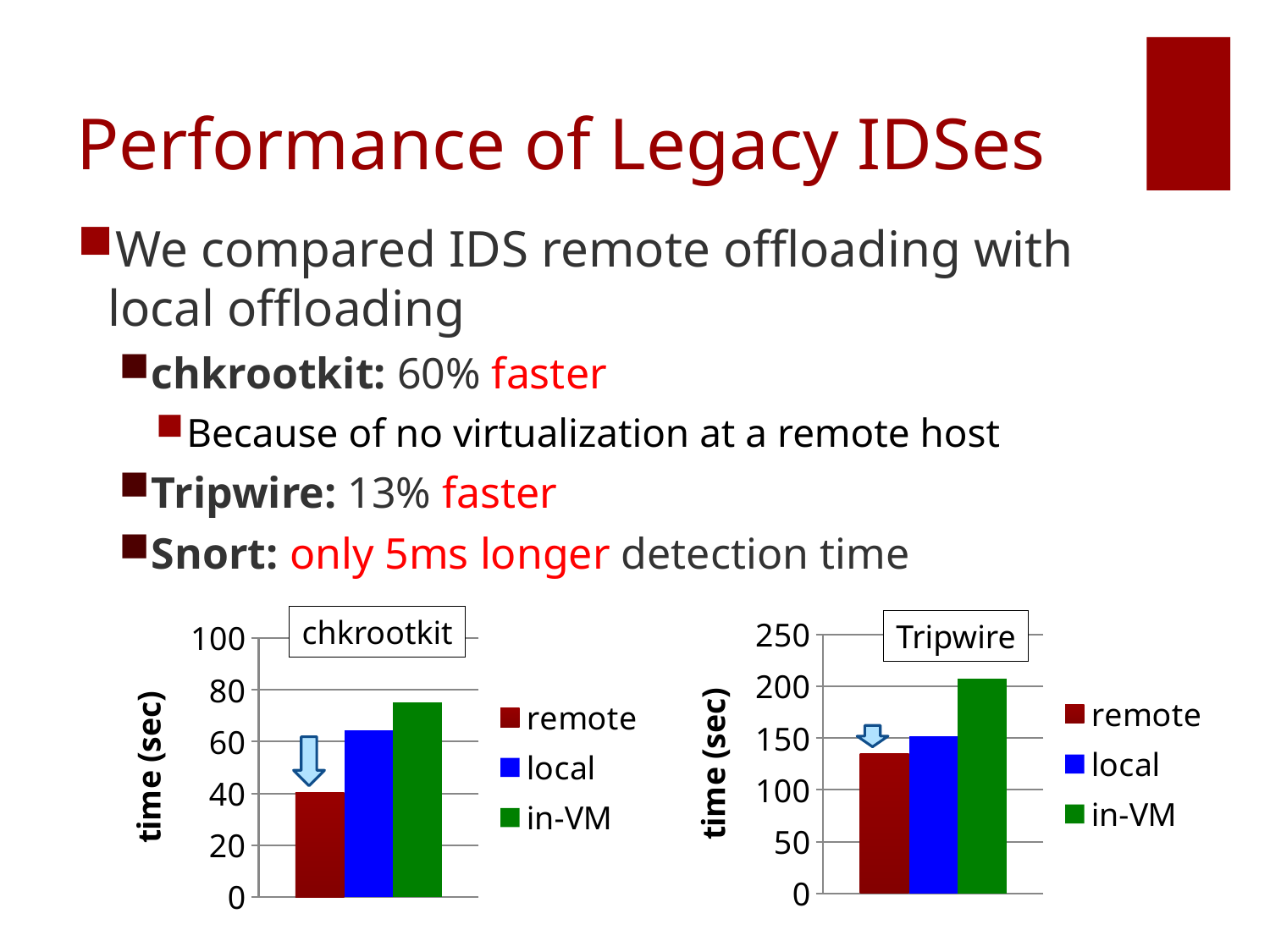
In the Tripwire chart, which series has the lowest time? remote In the Tripwire chart, is the value for remote greater or less than 150? less In the chkrootkit chart, is the value for local greater or less than 60? greater In the Tripwire chart, is the value for in-VM greater or less than 200? greater In the Tripwire chart, which is larger, local or remote? local In the chkrootkit chart, which series has the lowest time? remote How many series does the legend of the Tripwire chart list? 3 In the Tripwire chart, which series has the highest time? in-VM What kind of chart is the chkrootkit chart? bar chart What is the y-axis label of the chkrootkit chart? time (sec) In the chkrootkit chart, which series has the highest time? in-VM